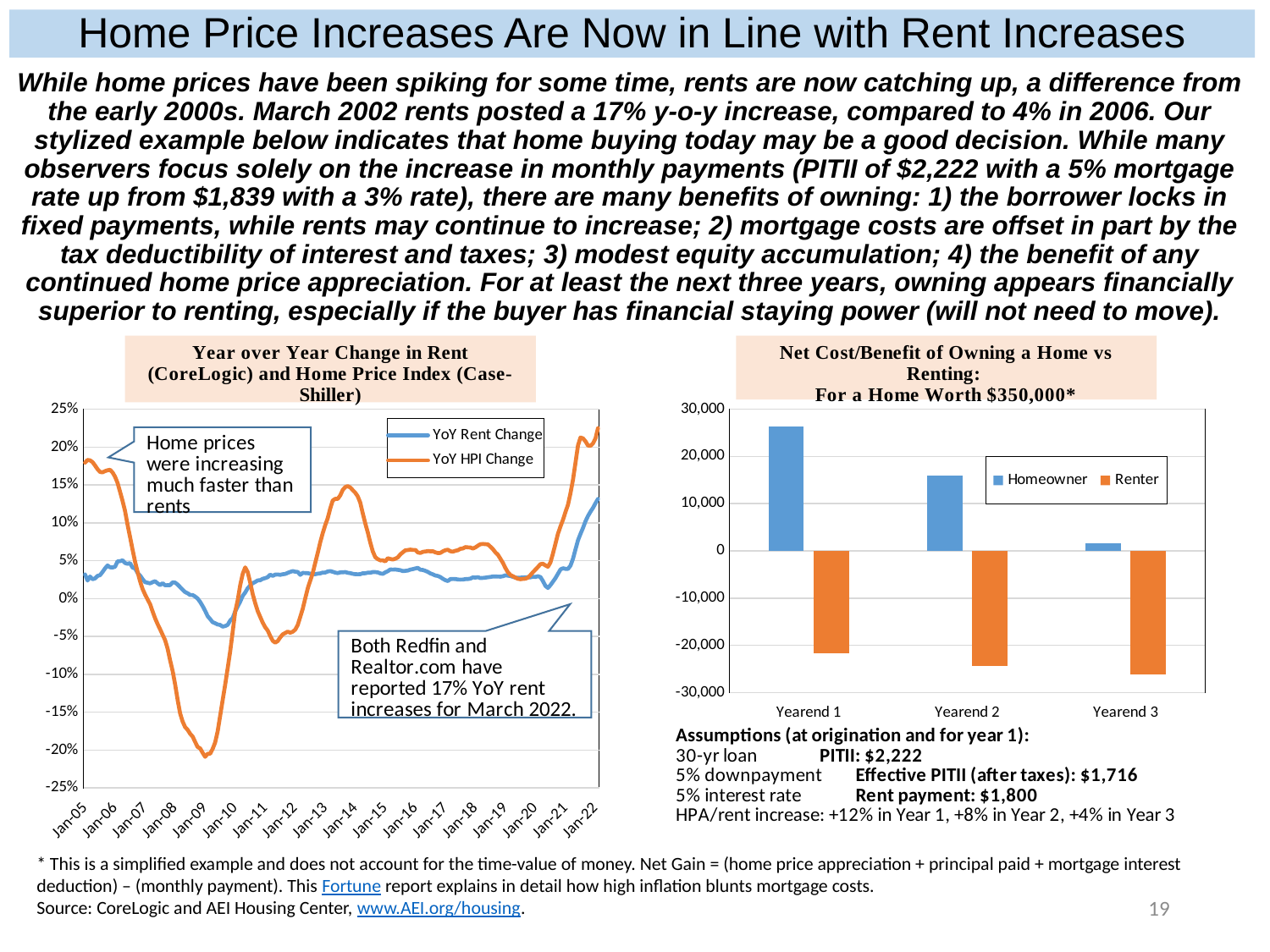
In the 'Net Cost/Benefit of Owning a Home vs Renting' chart, do the Homeowner values rise or fall from Yearend 1 to Yearend 3? Fall In the 'Net Cost/Benefit of Owning a Home vs Renting' chart, how many yearend categories are shown on the x axis? 3 In the 'Net Cost/Benefit of Owning a Home vs Renting' chart, is the Homeowner value for Yearend 3 greater or less than 10,000? less In the 'Net Cost/Benefit of Owning a Home vs Renting' chart, which yearend has the highest Homeowner value? Yearend 1 In the 'Net Cost/Benefit of Owning a Home vs Renting' chart, which is larger at Yearend 2: the Homeowner value or the Renter value? Homeowner In the left line chart, is the YoY HPI Change at Jan-09 greater or less than -15%? less In the 'Net Cost/Benefit of Owning a Home vs Renting' chart, is the Homeowner value for Yearend 1 greater or less than 20,000? greater In the 'Net Cost/Benefit of Owning a Home vs Renting' chart, how many series does the legend list? 2 What kind of chart is the 'Net Cost/Benefit of Owning a Home vs Renting' chart on the right? Bar chart In the left line chart, what are the two series listed in the legend? YoY Rent Change and YoY HPI Change What kind of chart is the 'Year over Year Change in Rent (CoreLogic) and Home Price Index (Case-Shiller)' chart on the left? Line chart In the 'Net Cost/Benefit of Owning a Home vs Renting' chart, which yearend has the lowest Homeowner value? Yearend 3